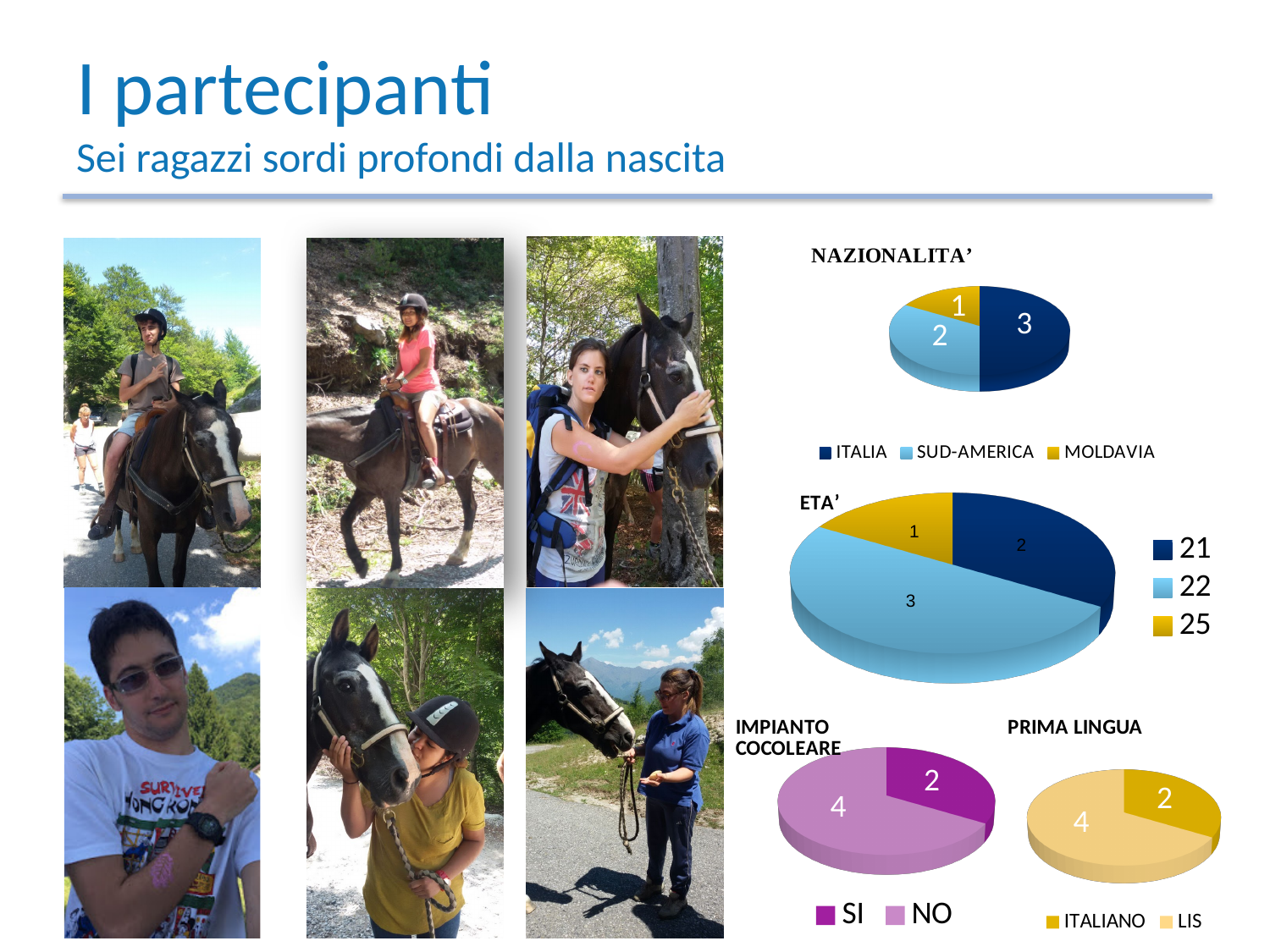
In the IMPIANTO COCOLEARE chart, which is larger, SI or NO? NO In the ETA' chart, which category has the highest value? 22 In the NAZIONALITA' chart, what is the value for ITALIA? 3 How many series does the legend of the NAZIONALITA' chart list? 3 In the ETA' chart, what is the value for 22? 3 In the ETA' chart, what is the difference between the values for 22 and 25? 2 In the PRIMA LINGUA chart, what share of the pie does LIS represent? 4 of 6 In the PRIMA LINGUA chart, what is the value for ITALIANO? 2 In the IMPIANTO COCOLEARE chart, what is the value for NO? 4 How many pie charts are shown on the slide? 4 What kind of chart is the ETA' chart? Pie chart In the NAZIONALITA' chart, which category has the lowest value? MOLDAVIA